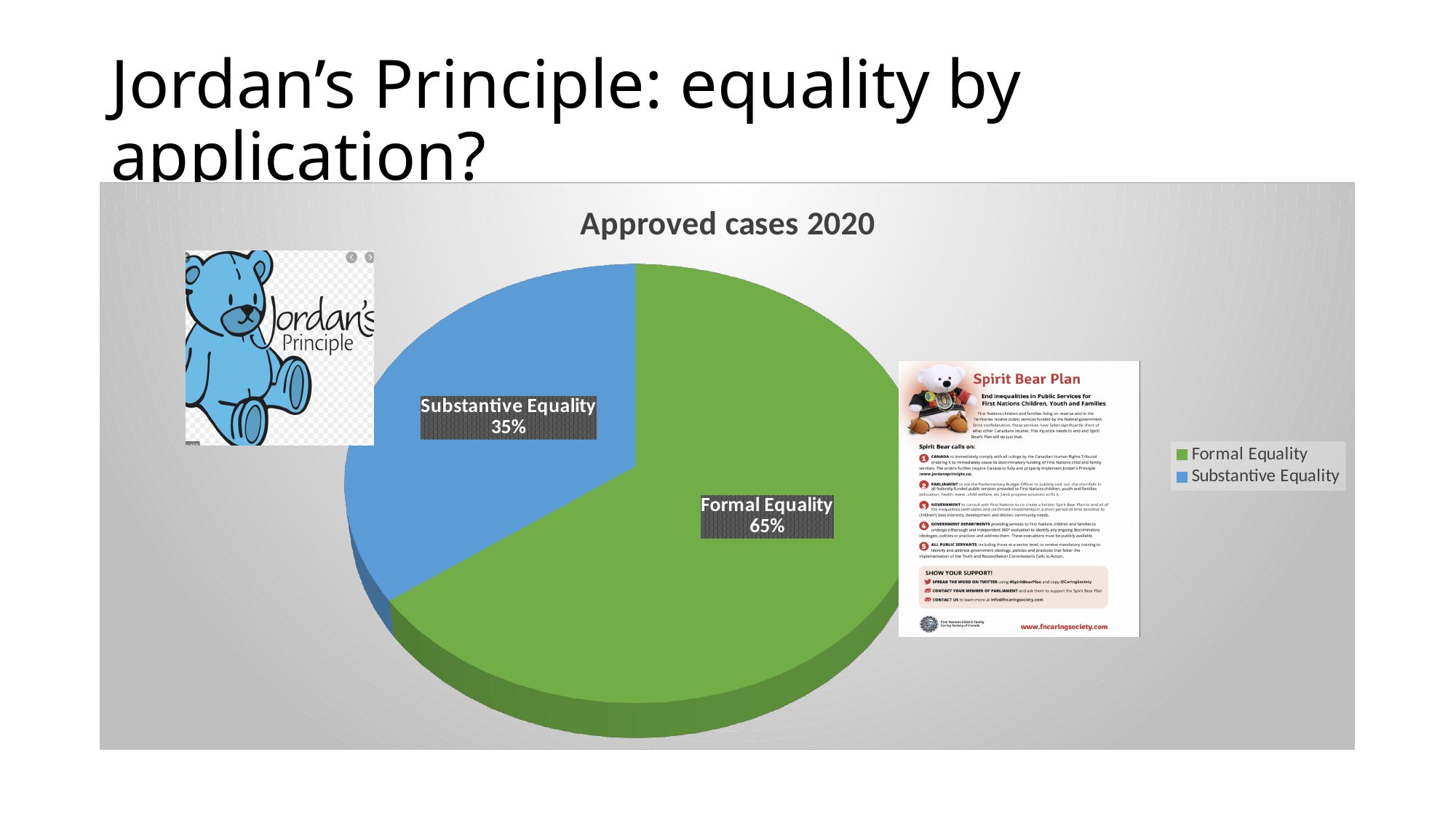
How many slices does the pie chart have? 2 Which is larger, Formal Equality or Substantive Equality? Formal Equality Which slice of the pie is the largest? Formal Equality What share of approved cases in 2020 is Substantive Equality? 35% What colour is the Substantive Equality slice? blue What is the difference in percentage points between Formal Equality and Substantive Equality? 30 What share of approved cases in 2020 is Formal Equality? 65% Which slice of the pie is the smallest? Substantive Equality What is the title of the chart? Approved cases 2020 What kind of chart is shown on the slide? pie chart How many entries does the legend list? 2